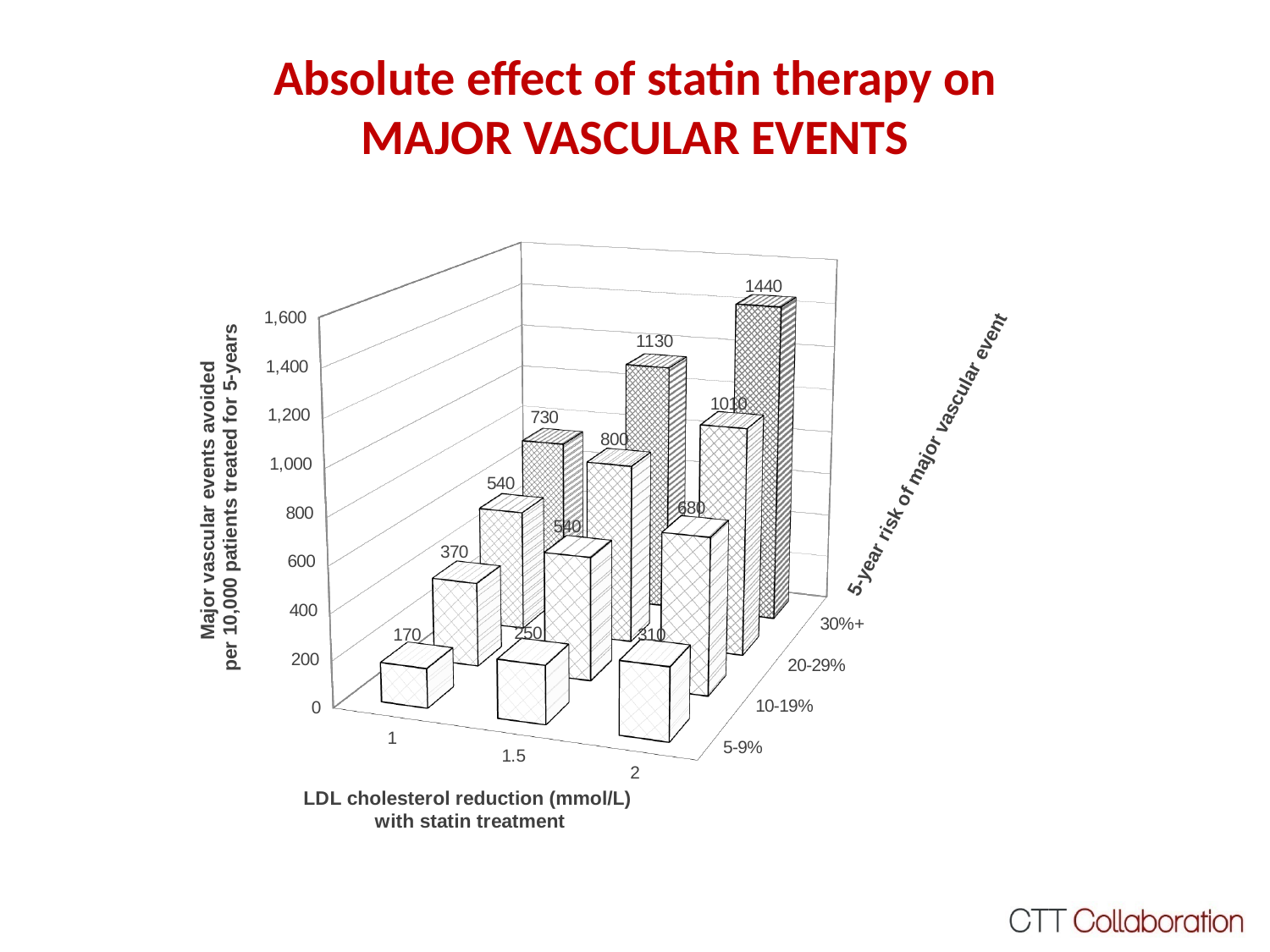
For an LDL reduction of 1 mmol/L, what is the difference between the 30%+ and 5-9% risk groups? 560 What is the value for an LDL cholesterol reduction of 1.5 mmol/L in the 30%+ risk group? 1130 In the 30%+ risk group, what is the difference between the values for 2 mmol/L and 1 mmol/L LDL reduction? 710 What kind of chart is shown on the slide? Bar chart What is the value for an LDL cholesterol reduction of 1 mmol/L in the 5-9% risk group? 170 Which is larger: the value for 1.5 mmol/L in the 30%+ group or the value for 2 mmol/L in the 20-29% group? 1.5 mmol/L in the 30%+ group Within the 30%+ risk group, do the values rise or fall as LDL cholesterol reduction increases from 1 to 2 mmol/L? Rise Which combination of LDL cholesterol reduction and risk group has the highest number of major vascular events avoided? 2 mmol/L, 30%+ What is the value for an LDL cholesterol reduction of 2 mmol/L in the 30%+ risk group? 1440 Which combination of LDL cholesterol reduction and risk group has the lowest number of major vascular events avoided? 1 mmol/L, 5-9% How many 5-year risk categories are shown on the chart? 4 What is the value for an LDL cholesterol reduction of 1 mmol/L in the 30%+ risk group? 730